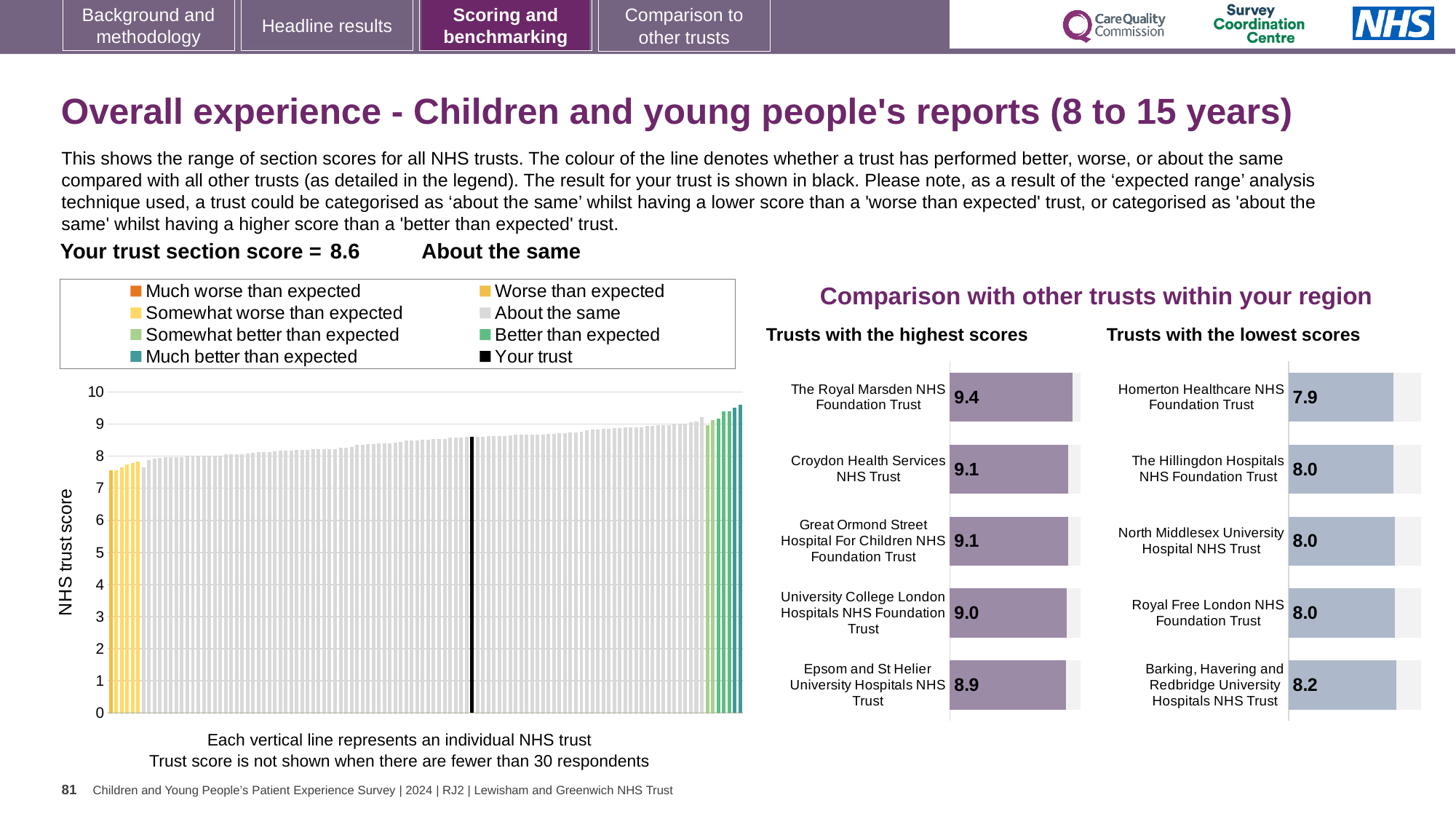
In the 'Trusts with the lowest scores' chart, what is the score for Homerton Healthcare NHS Foundation Trust? 7.9 In the 'Trusts with the highest scores' chart, what is the score for The Royal Marsden NHS Foundation Trust? 9.4 How many trusts are shown in the 'Trusts with the lowest scores' chart? 5 What kind of chart is the NHS trust score chart on the left of the slide? Bar chart In the 'Trusts with the highest scores' chart, which has the larger score: Croydon Health Services NHS Trust or University College London Hospitals NHS Foundation Trust? Croydon Health Services NHS Trust In the 'Trusts with the highest scores' chart, which trust has the highest score? The Royal Marsden NHS Foundation Trust How many entries does the legend of the NHS trust score chart on the left list? 8 In the NHS trust score chart on the left, do the bar values rise or fall from left to right? Rise In the 'Trusts with the lowest scores' chart, which trust has the lowest score? Homerton Healthcare NHS Foundation Trust In the 'Trusts with the lowest scores' chart, what is the score for Barking, Havering and Redbridge University Hospitals NHS Trust? 8.2 In the 'Trusts with the highest scores' chart, what is the difference between the scores of The Royal Marsden NHS Foundation Trust and Epsom and St Helier University Hospitals NHS Trust? 0.5 In the NHS trust score chart on the left, what is the score of the black bar representing your trust? 8.6